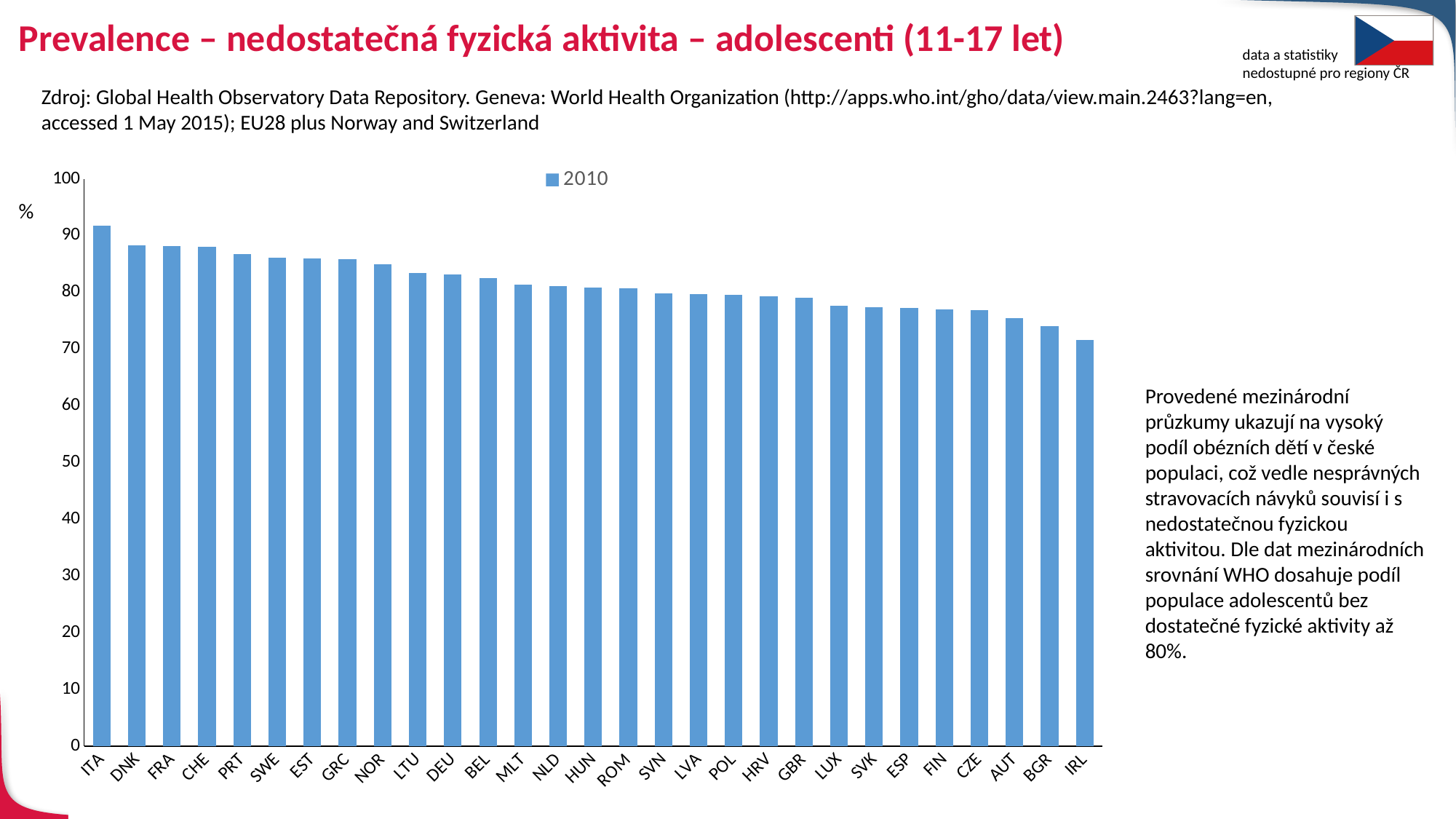
Which country has the highest value in the chart? ITA What kind of chart is shown on the slide? bar chart How many series does the chart legend list? 1 Is the value for BGR greater or less than 80? less Which year does the legend entry of the chart refer to? 2010 How many countries are shown on the x axis of the chart? 29 Which has the larger value, NOR or AUT? NOR Which has the larger value, ITA or IRL? ITA Is the value for DNK greater or less than 80? greater Do the values rise or fall from left to right along the x axis? fall Is the value for IRL greater or less than 80? less Which country has the lowest value in the chart? IRL